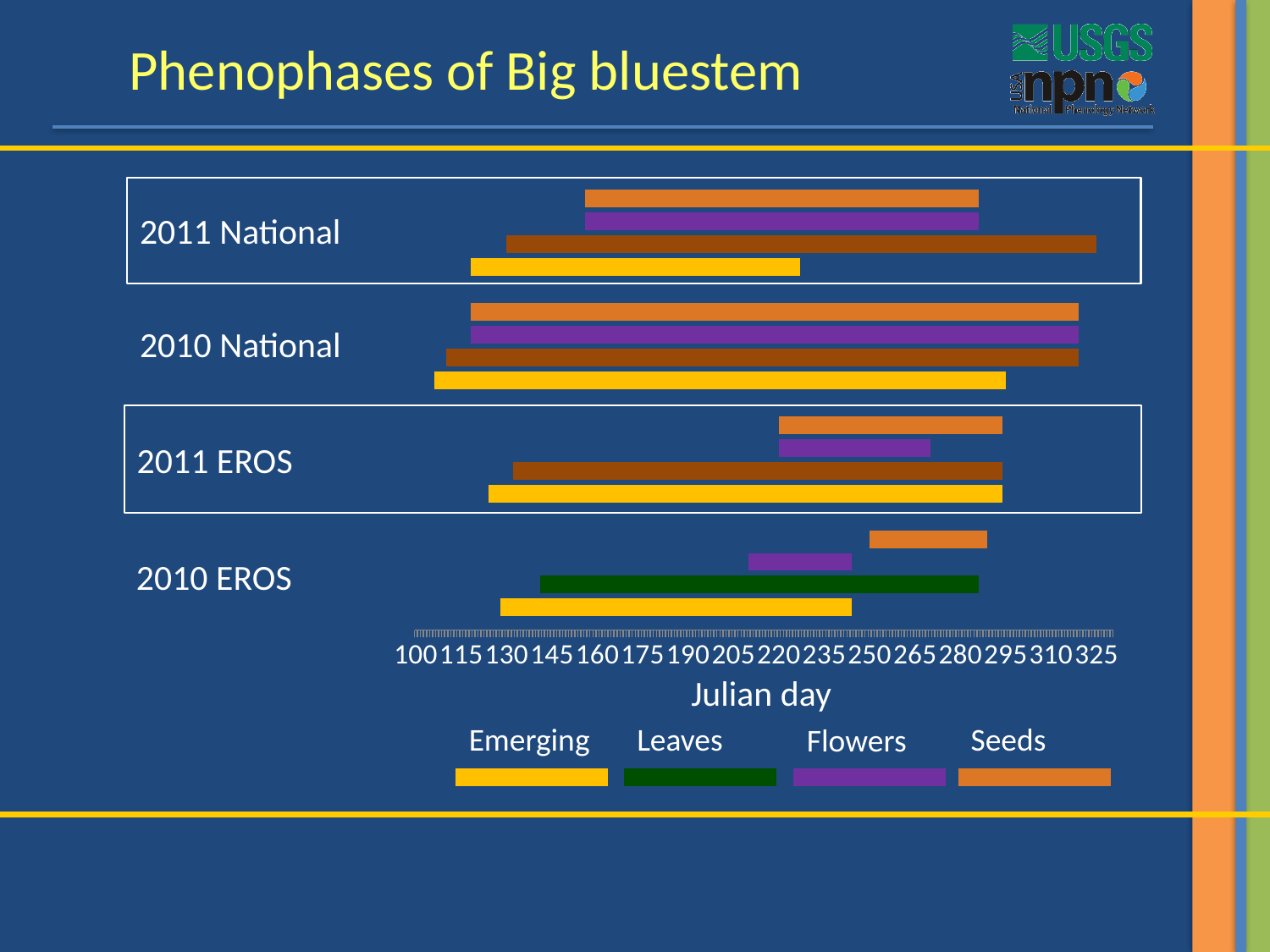
Which group has the shortest Flowers bar? 2010 EROS How many year/location groups are plotted on the chart? 4 Is the end of the Emerging bar for 2011 National greater or less than Julian day 250? less What kind of chart is shown on the slide? Bar chart Which colour represents the Emerging phenophase in the legend? Yellow How many phenophases does the legend list? 4 Is the start of the Seeds bar for 2010 EROS greater or less than Julian day 235? greater For 2011 EROS, which bar is longer, Seeds or Flowers? Seeds Which group has the longest Seeds bar? 2010 National Which group has the shortest Seeds bar? 2010 EROS What is the title of the x axis? Julian day